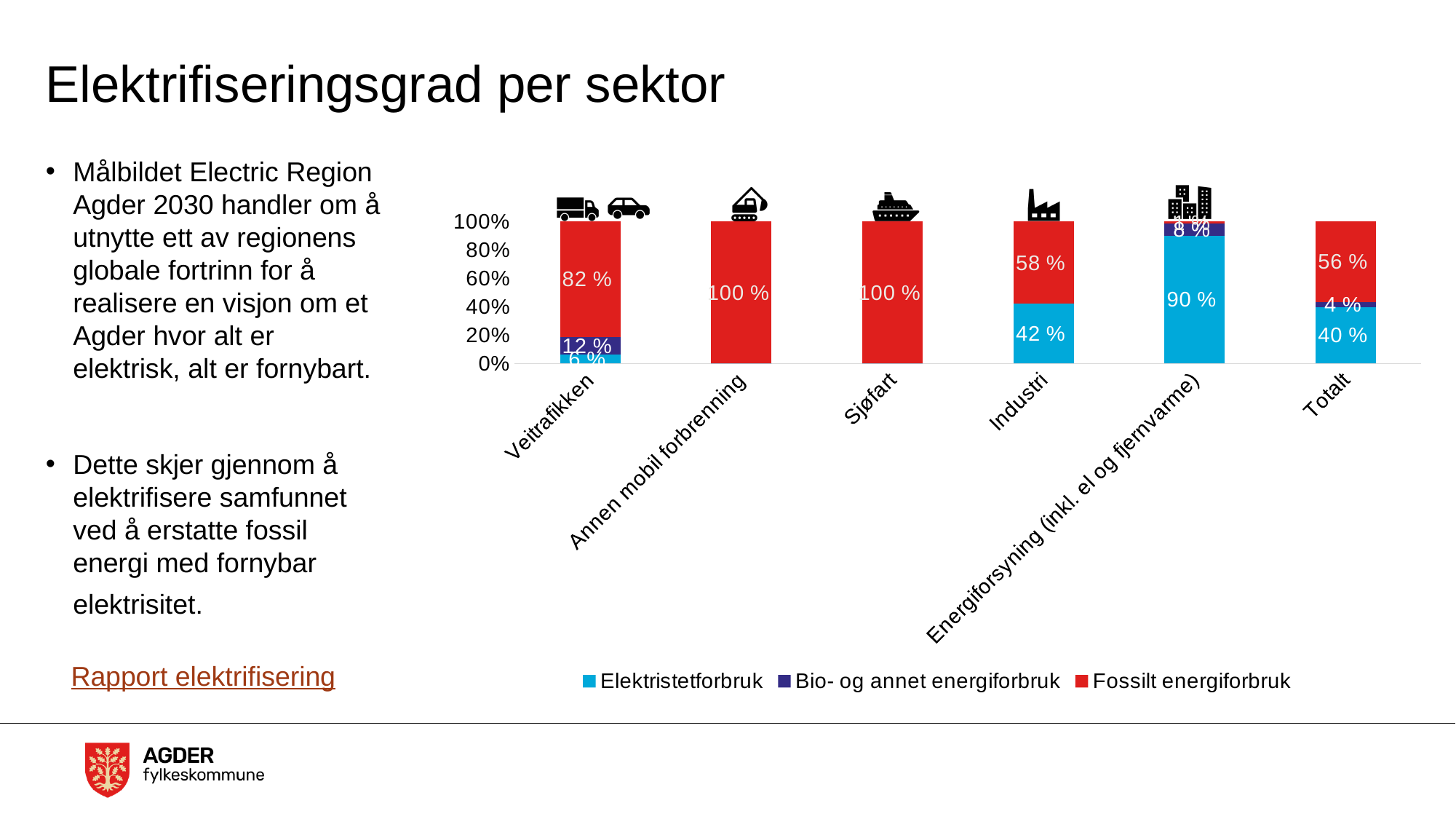
What is the share of Bio- og annet energiforbruk for Totalt? 4 % What is the difference between the Fossilt energiforbruk share for Industri and for Totalt? 2 % What is the share of Elektristetforbruk for Energiforsyning (inkl. el og fjernvarme)? 90 % Which sector has the lowest share of Fossilt energiforbruk? Energiforsyning (inkl. el og fjernvarme) How many sectors (categories) are shown on the x axis of the chart? 6 Which sector has the highest share of Elektristetforbruk? Energiforsyning (inkl. el og fjernvarme) Which is larger: the Elektristetforbruk share for Industri or for Totalt? Industri What is the share of Fossilt energiforbruk for Veitrafikken? 82 % What kind of chart is shown on the slide? Stacked bar chart What is the share of Elektristetforbruk for Industri? 42 % Which series is shown in red in the chart? Fossilt energiforbruk How many series does the chart legend list? 3